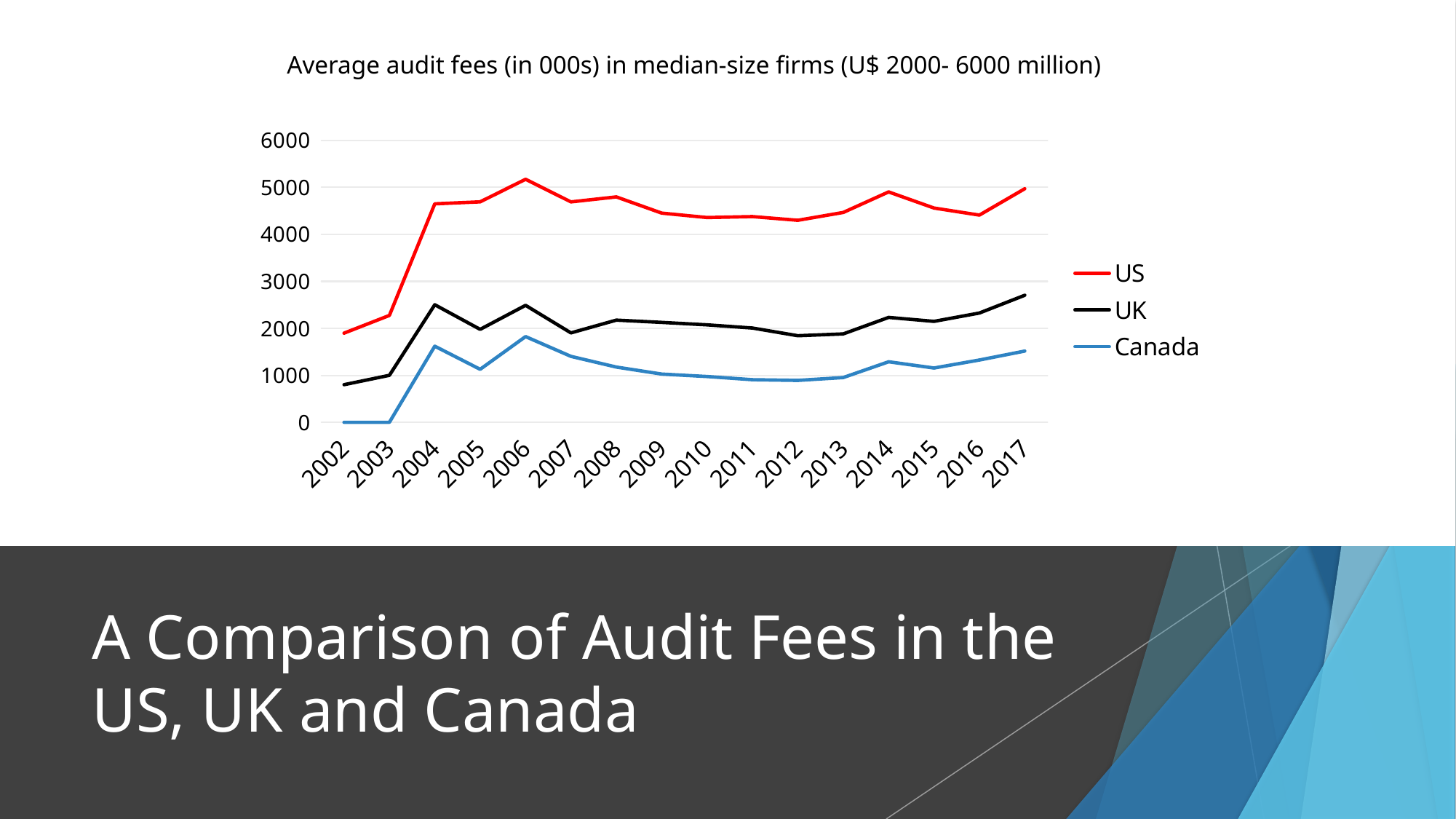
What kind of chart is shown on the slide? line chart Is the value for Canada in 2006 greater or less than 1000? greater Which series has the larger value in 2010, US or UK? US In which year does the UK series have its lowest value? 2002 Is the value for the UK in 2002 greater or less than 1000? less How many years are plotted along the x axis? 16 Do the values for Canada rise or fall from 2006 to 2012? fall In which year does the US series reach its highest value? 2006 Which series is drawn in red? US What is the value for Canada in 2002? 0 How many series does the legend list? 3 Is the value for the US in 2006 greater or less than 5000? greater